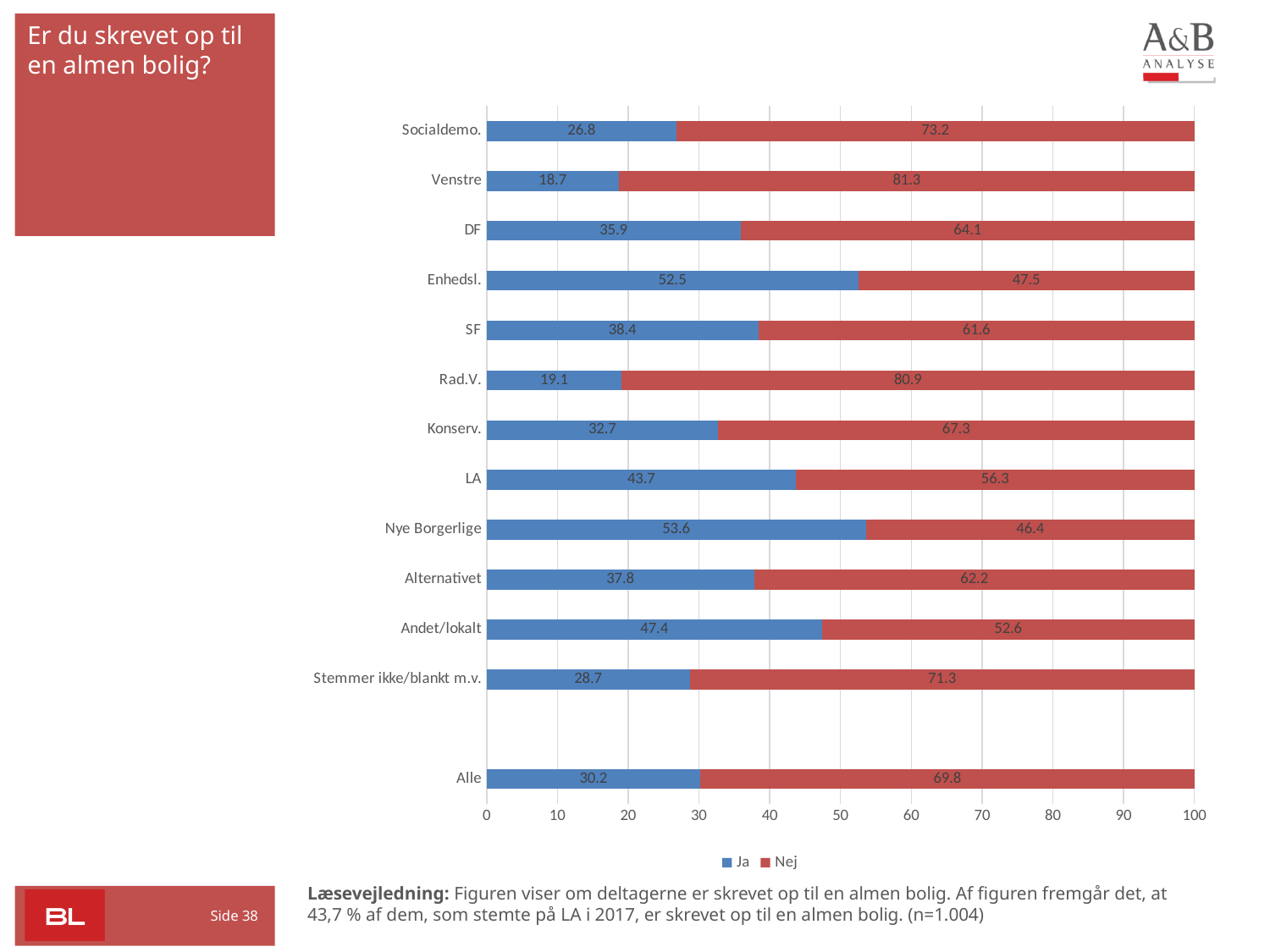
How many categories are shown on the y axis? 13 Is the "Ja" value for Konserv. greater or less than 30? greater What is the difference between the "Nej" values for Socialdemo. and DF? 9.1 What is the total of the stacked bar for Rad.V.? 100 Which category has the lowest "Ja" value? Venstre What is the "Ja" value for Alle? 30.2 What is the "Ja" value for Enhedsl.? 52.5 How many series does the legend list? 2 What is the "Nej" value for Venstre? 81.3 Which category has the highest "Ja" value? Nye Borgerlige What kind of chart is shown? Stacked bar chart Which has a larger "Ja" value, LA or SF? LA